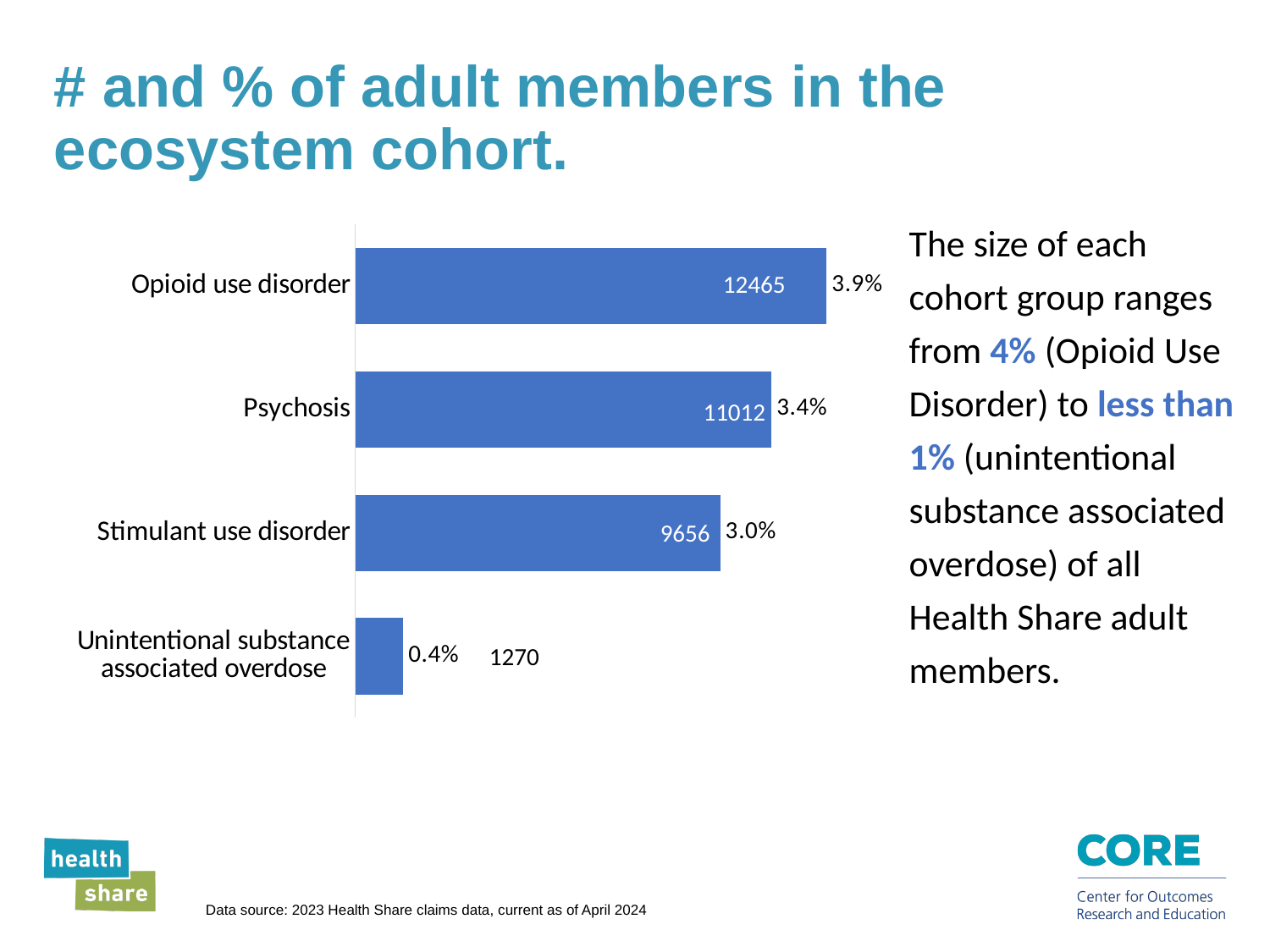
How many cohort groups are shown in the chart? 4 What percentage is shown for Unintentional substance associated overdose? 0.4% What is the title of the slide containing the chart? # and % of adult members in the ecosystem cohort. What is the difference in member count between Stimulant use disorder and Unintentional substance associated overdose? 8386 Which has more members, Psychosis or Stimulant use disorder? Psychosis What percentage of adult members is shown for Psychosis? 3.4% How many adult members are in the Opioid use disorder cohort group? 12465 What is the difference in member count between Opioid use disorder and Psychosis? 1453 Which cohort group has the largest number of members? Opioid use disorder Which cohort group has the smallest number of members? Unintentional substance associated overdose What type of chart is shown on the slide? Bar chart How many members are shown for Stimulant use disorder? 9656